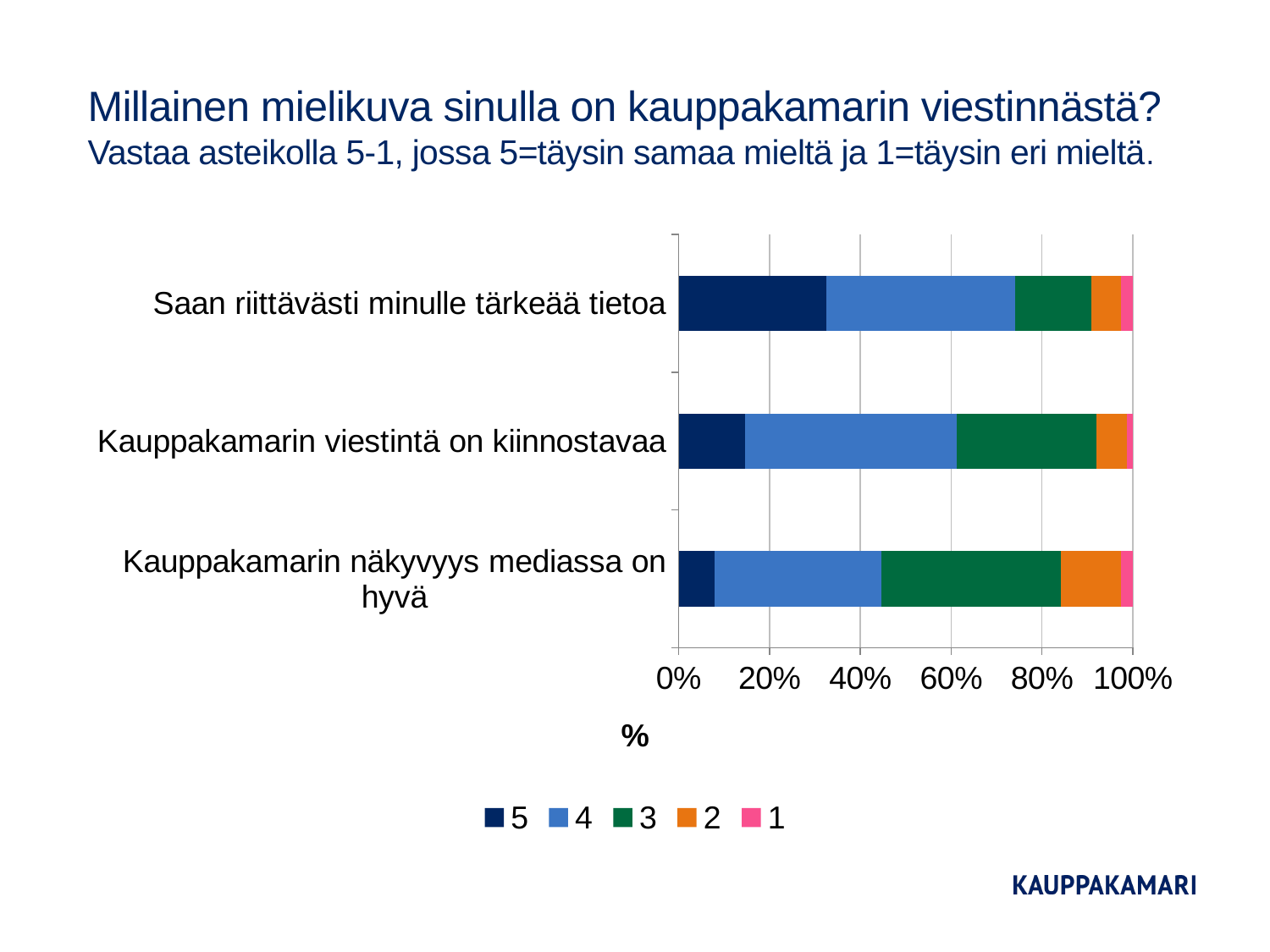
Which statement has the smallest share of '5' responses? Kauppakamarin näkyvyys mediassa on hyvä Which statement has a larger share of '4' responses: 'Kauppakamarin viestintä on kiinnostavaa' or 'Kauppakamarin näkyvyys mediassa on hyvä'? Kauppakamarin viestintä on kiinnostavaa What is the title of the horizontal axis? % What are the legend entries of the chart, in order? 5, 4, 3, 2, 1 Is the share of '5' responses for 'Kauppakamarin näkyvyys mediassa on hyvä' greater or less than 20%? less Which statement has the largest share of '5' (täysin samaa mieltä) responses? Saan riittävästi minulle tärkeää tietoa How many statements (categories) are plotted on the chart? 3 Which statement has the largest share of '3' responses? Kauppakamarin näkyvyys mediassa on hyvä Is the share of '5' responses for 'Saan riittävästi minulle tärkeää tietoa' greater or less than 20%? greater What kind of chart is shown on the slide? Stacked bar chart How many series does the legend list? 5 Which statement has the largest share of '2' responses? Kauppakamarin näkyvyys mediassa on hyvä